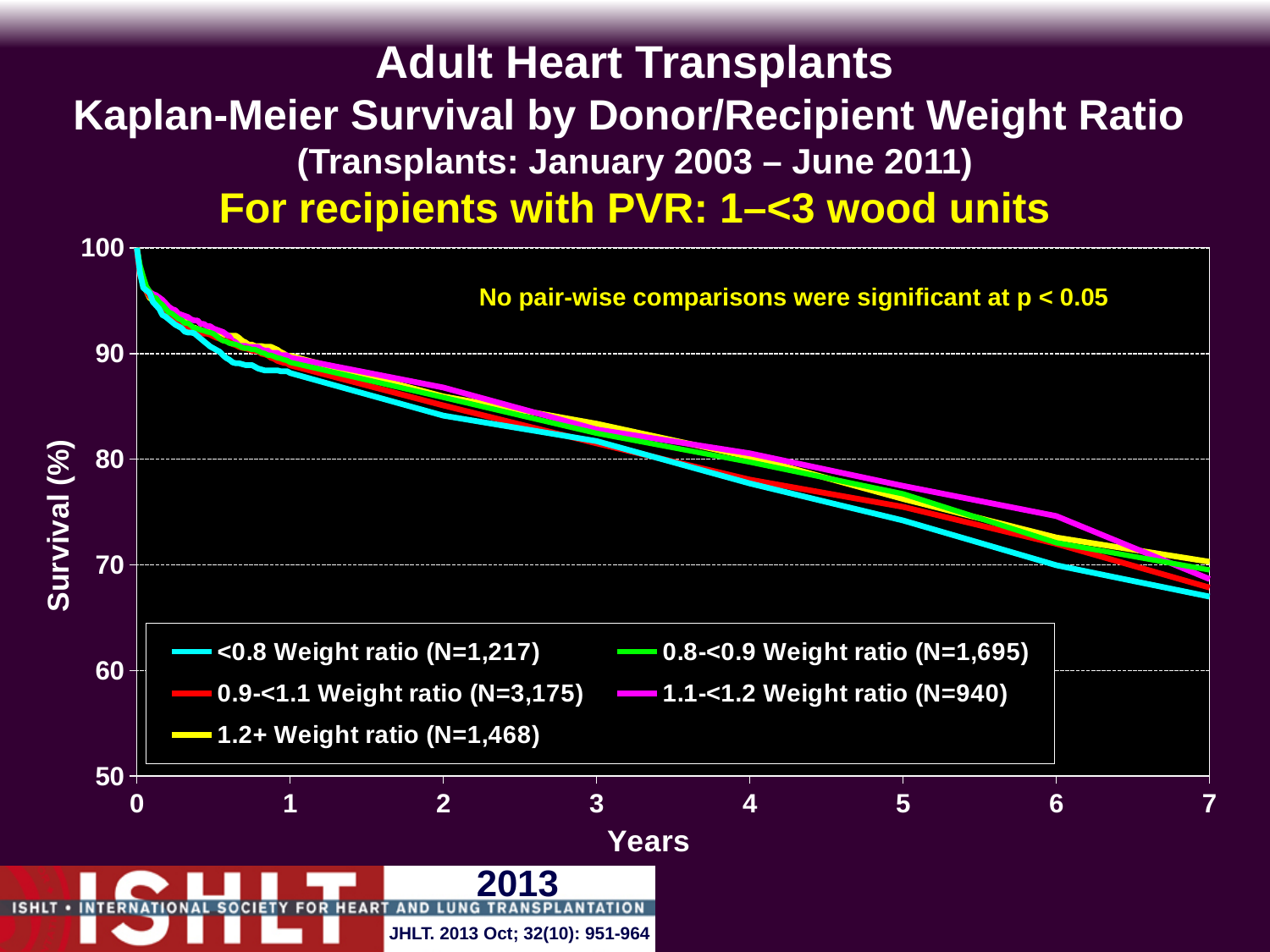
What is the N for the 0.9-<1.1 Weight ratio group shown in the legend? N=3,175 Is the survival value for the 0.8-<0.9 Weight ratio group at 2 years greater or less than 80? greater Is the survival value for the <0.8 Weight ratio group at 5 years greater or less than 70? greater How many series does the legend list? 5 What is the N for the 1.1-<1.2 Weight ratio group shown in the legend? N=940 Is the survival value for the 1.1-<1.2 Weight ratio group at 6 years greater or less than 70? greater What kind of chart is shown on the slide? line chart Do the survival curves rise or fall as years increase along the x axis? fall Which weight ratio group has the lowest survival at 7 years? <0.8 Weight ratio